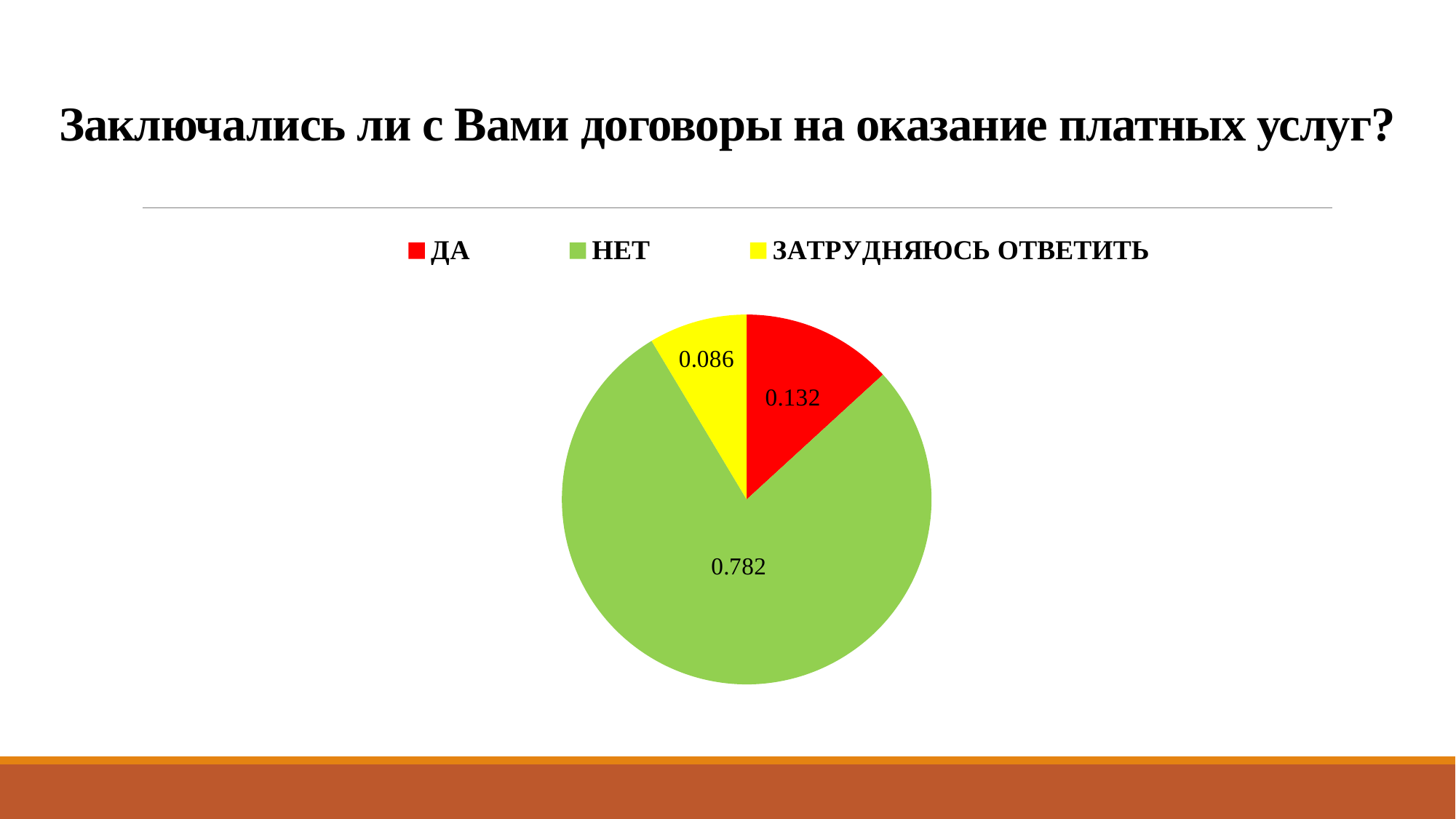
What colour is the slice for НЕТ? green What is the difference between the values for НЕТ and ДА? 0.650 What is the value for ДА? 0.132 What is the value for ЗАТРУДНЯЮСЬ ОТВЕТИТЬ? 0.086 What is the difference between the values for ДА and ЗАТРУДНЯЮСЬ ОТВЕТИТЬ? 0.046 How many categories does the pie chart have? 3 Which category has the largest slice? НЕТ What type of chart is shown on the slide? pie chart What is the title of the slide above the chart? Заключались ли с Вами договоры на оказание платных услуг? Which is larger, the value for ДА or the value for ЗАТРУДНЯЮСЬ ОТВЕТИТЬ? ДА Which category has the smallest slice? ЗАТРУДНЯЮСЬ ОТВЕТИТЬ What is the value for НЕТ? 0.782